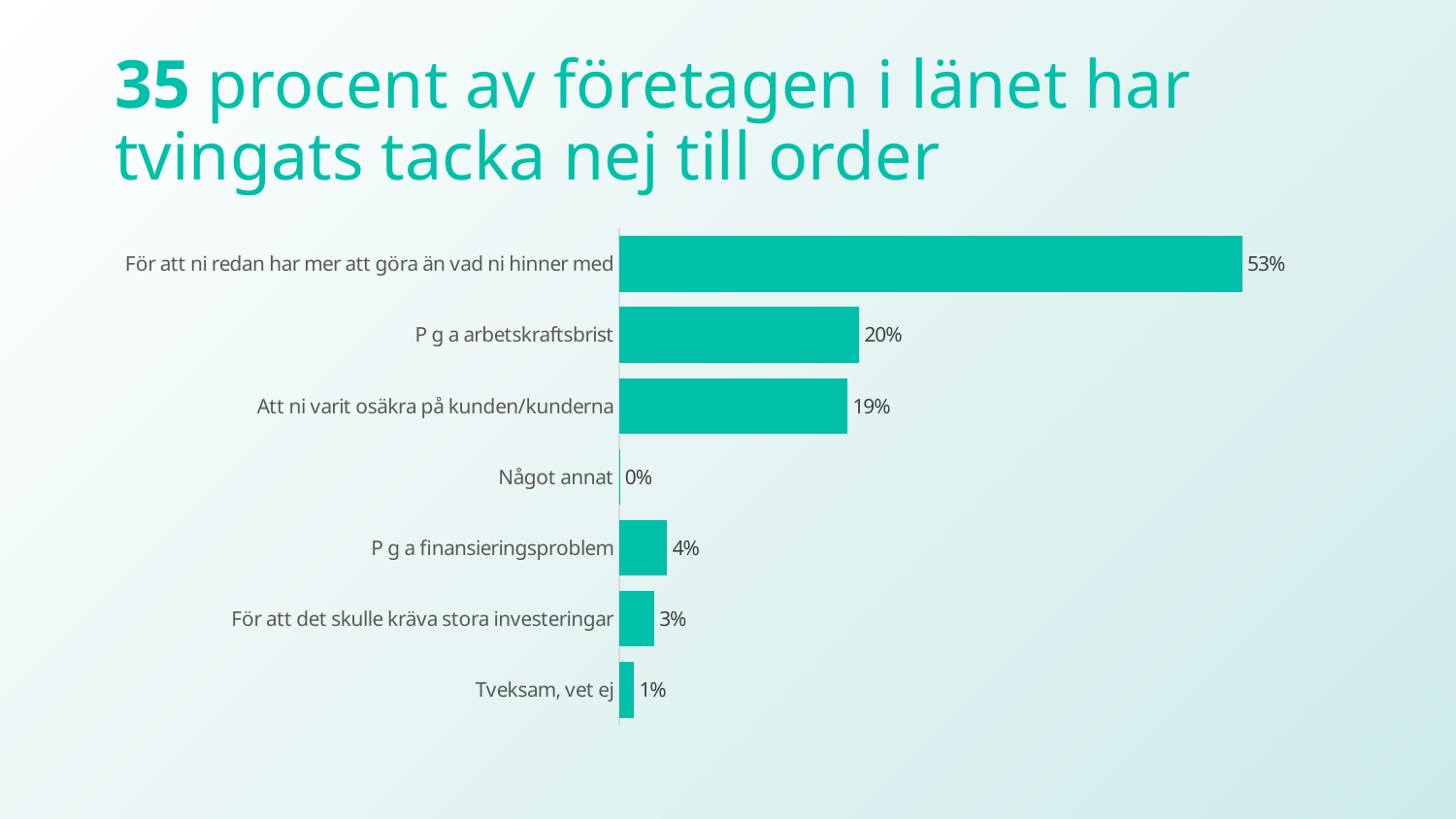
What is the value for "P g a finansieringsproblem"? 4% What is the value for "P g a arbetskraftsbrist"? 20% What kind of chart is shown on the slide? Bar chart What is the title of the slide? 35 procent av företagen i länet har tvingats tacka nej till order Which category has the highest value? För att ni redan har mer att göra än vad ni hinner med What is the difference between "För att ni redan har mer att göra än vad ni hinner med" and "P g a arbetskraftsbrist"? 33% How many categories are shown in the chart? 7 What is the value for "Att ni varit osäkra på kunden/kunderna"? 19% What is the value for "Tveksam, vet ej"? 1% Which category has the lowest value? Något annat Which is larger: "P g a finansieringsproblem" or "För att det skulle kräva stora investeringar"? P g a finansieringsproblem What is the value for "För att ni redan har mer att göra än vad ni hinner med"? 53%